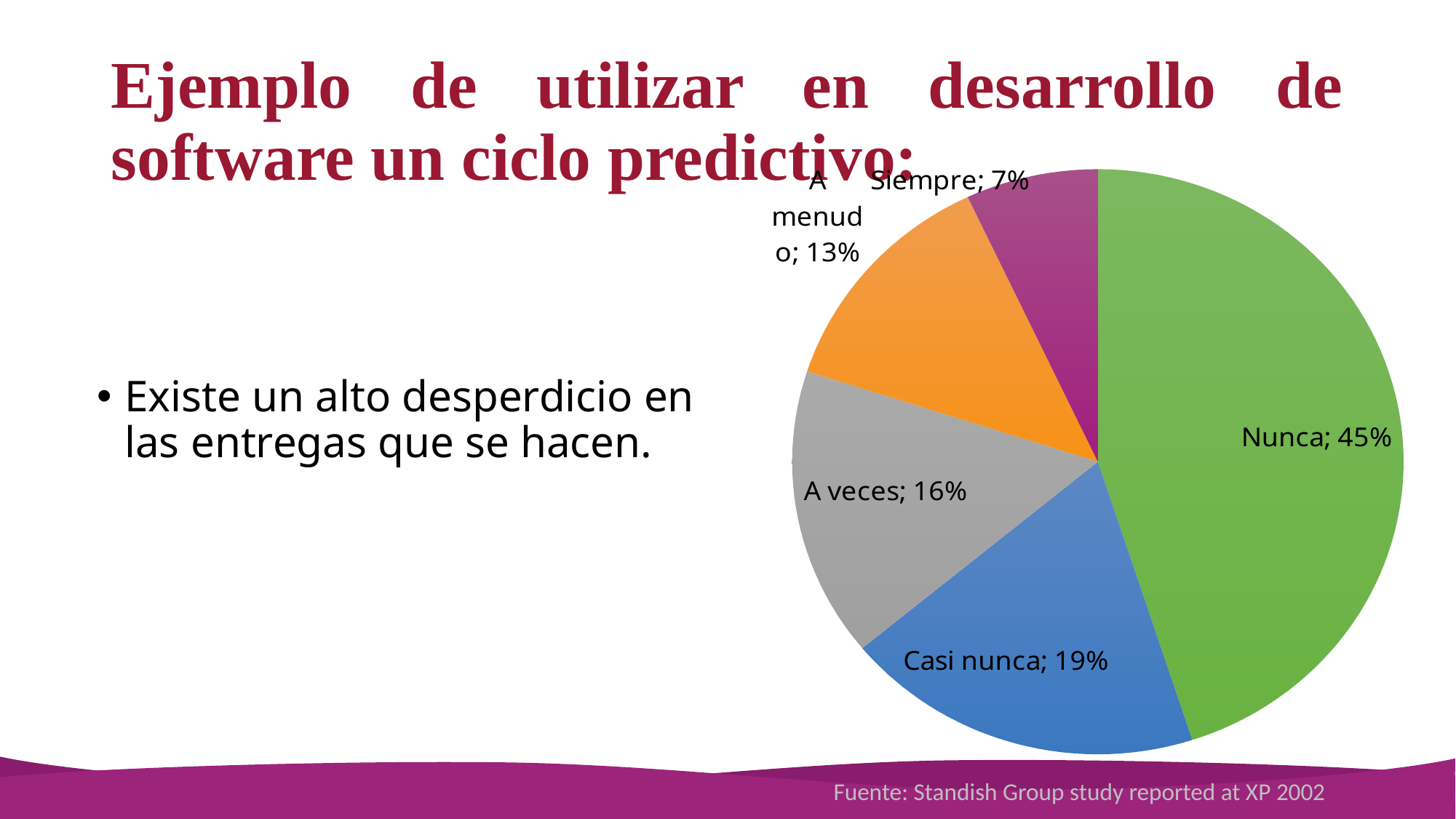
Which slice of the pie chart is the smallest? Siempre What percentage is shown for the "Casi nunca" slice? 19% How many slices does the pie chart have? 5 Which slice of the pie chart is the largest? Nunca What is the difference in percentage points between the "Nunca" and "Casi nunca" slices? 26 What percentage is shown for the "A menudo" slice? 13% What percentage is shown for the "Nunca" slice? 45% What colour is the "Nunca" slice? green What kind of chart is shown on the slide? pie chart What percentage is shown for the "A veces" slice? 16% Which is larger, the "A veces" slice or the "A menudo" slice? A veces What percentage is shown for the "Siempre" slice? 7%